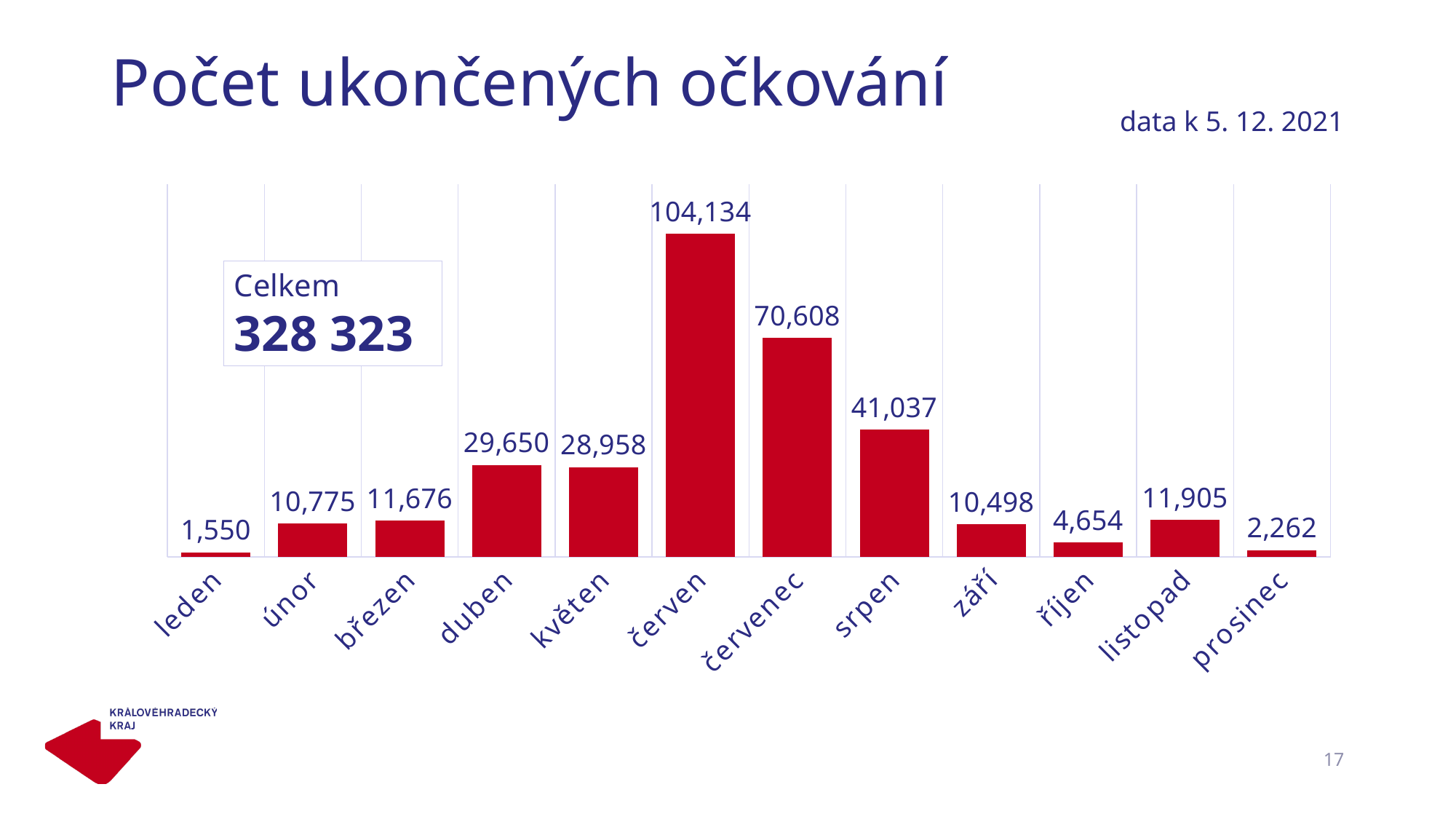
What is the value for leden? 1,550 What total (Celkem) is shown in the box on the chart? 328 323 What is the difference between the values for červen and červenec? 33,526 Which is larger, the value for červenec or the value for srpen? červenec What is the difference between the values for srpen and září? 30,539 How many months are shown on the x axis? 12 Which month has the lowest value? leden Which month has the highest value? červen Which is larger, the value for říjen or the value for prosinec? říjen What is the value for červen? 104,134 What kind of chart is shown on the slide? bar chart What is the value for listopad? 11,905